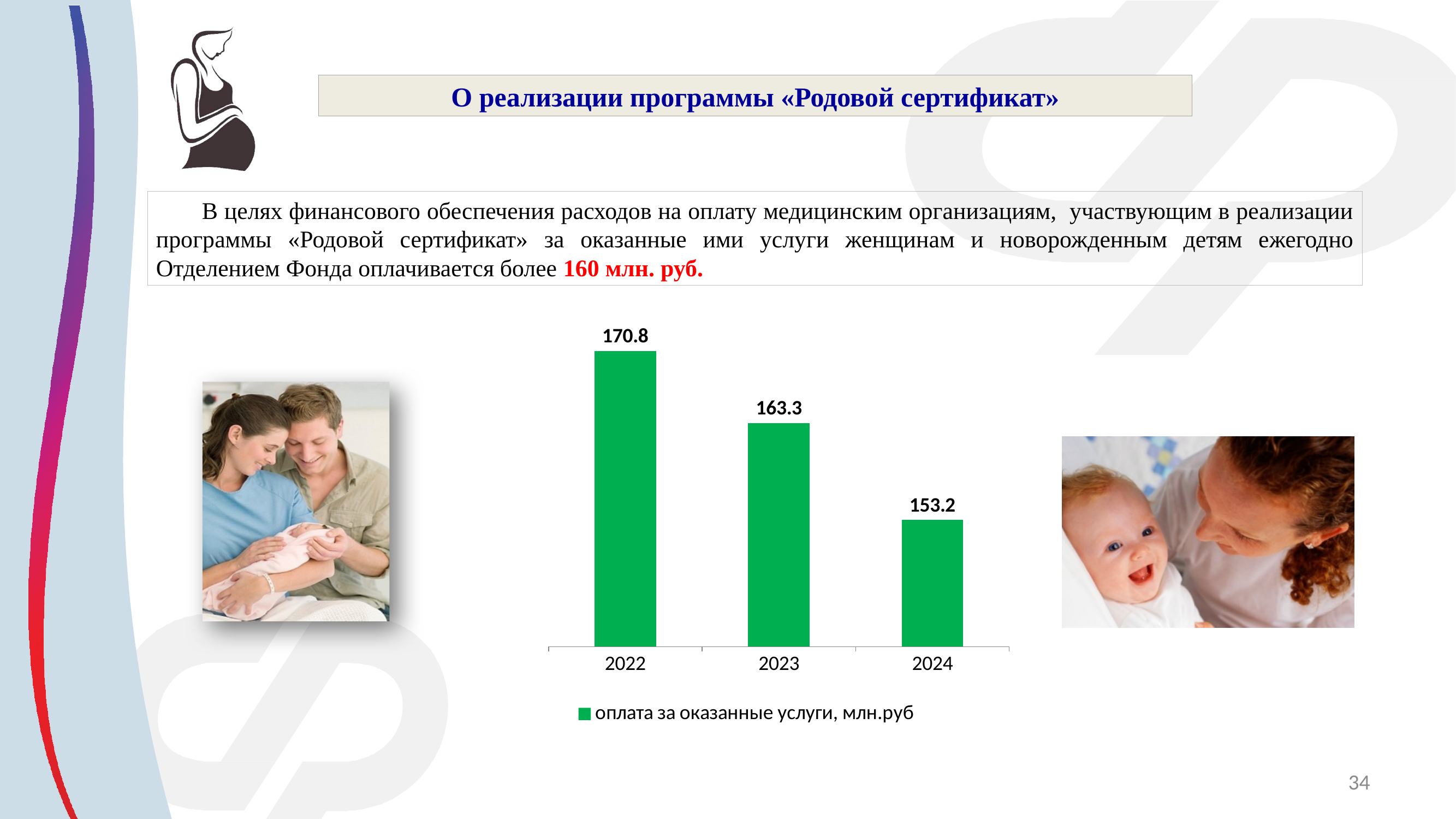
Do the values rise or fall from 2022 to 2024? fall Which is larger, the value for 2023 or the value for 2024? 2023 What kind of chart is shown on the slide? bar chart What is the difference between the values for 2022 and 2024? 17.6 Which year has the highest value in the chart? 2022 What is the value for 2024 in the chart? 153.2 What is the value for 2023 in the chart? 163.3 How many years are shown in the chart? 3 What is the difference between the values for 2022 and 2023? 7.5 What is the value for 2022 in the chart? 170.8 How many series does the legend list? 1 Which year has the lowest value in the chart? 2024